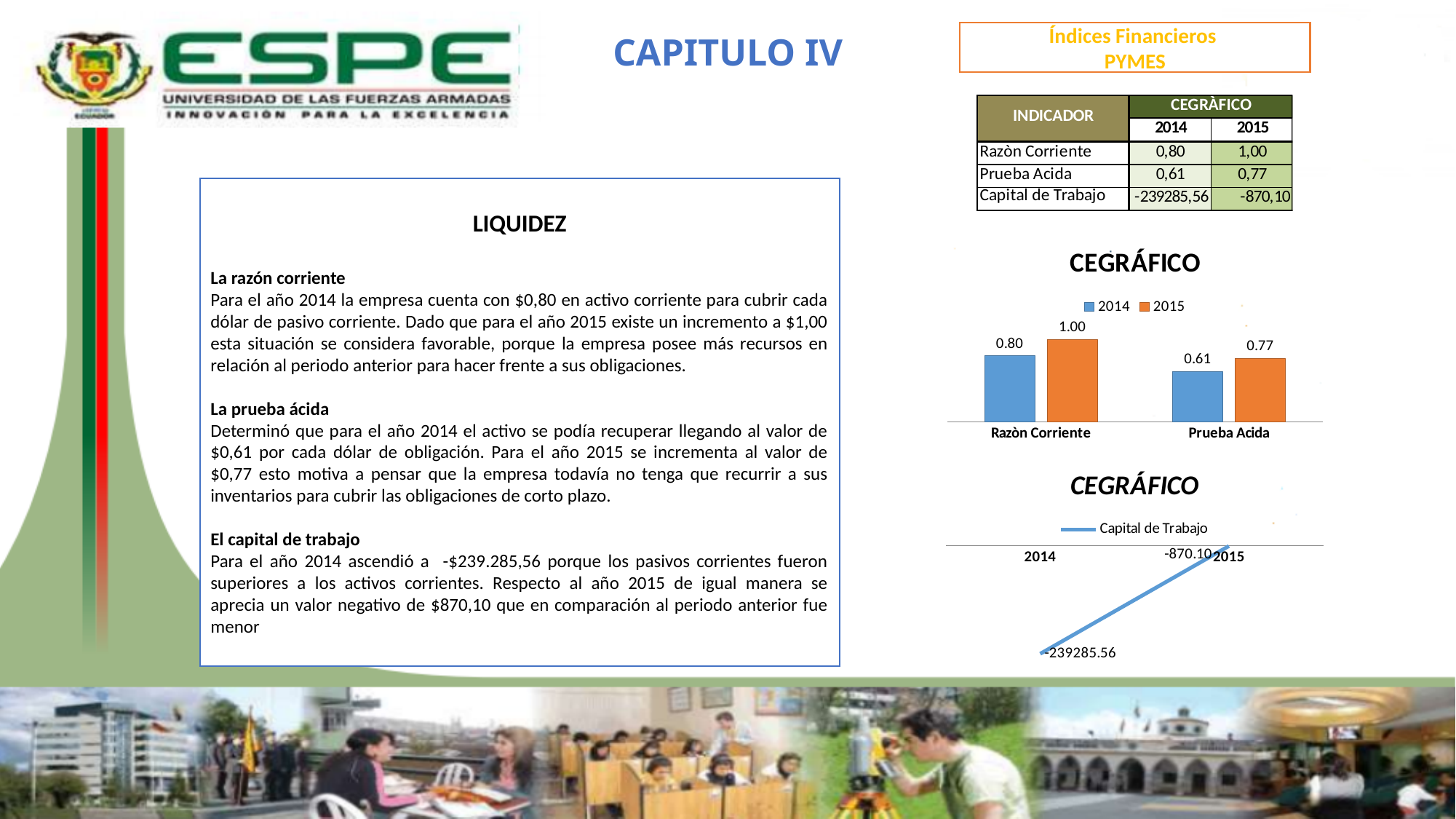
In the upper bar chart, what is the 2015 value for Prueba Acida? 0.77 In the upper bar chart, which is larger for Prueba Acida: the 2014 value or the 2015 value? 2015 In the upper bar chart, what is the 2014 value for Razòn Corriente? 0.80 In the lower line chart, does the Capital de Trabajo line rise or fall from 2014 to 2015? Rise In the upper bar chart, what is the 2014 value for Prueba Acida? 0.61 In the upper bar chart, what is the 2015 value for Razòn Corriente? 1.00 In the lower line chart, what is the Capital de Trabajo value for 2014? -239285.56 In the lower line chart, what is the Capital de Trabajo value for 2015? -870.10 How many series does the legend of the upper bar chart list? 2 In the upper bar chart, which category has the highest 2015 value? Razòn Corriente In the upper bar chart, what is the difference between the 2015 and 2014 values for Razòn Corriente? 0.20 What kind of chart is the upper chart on the slide? Bar chart